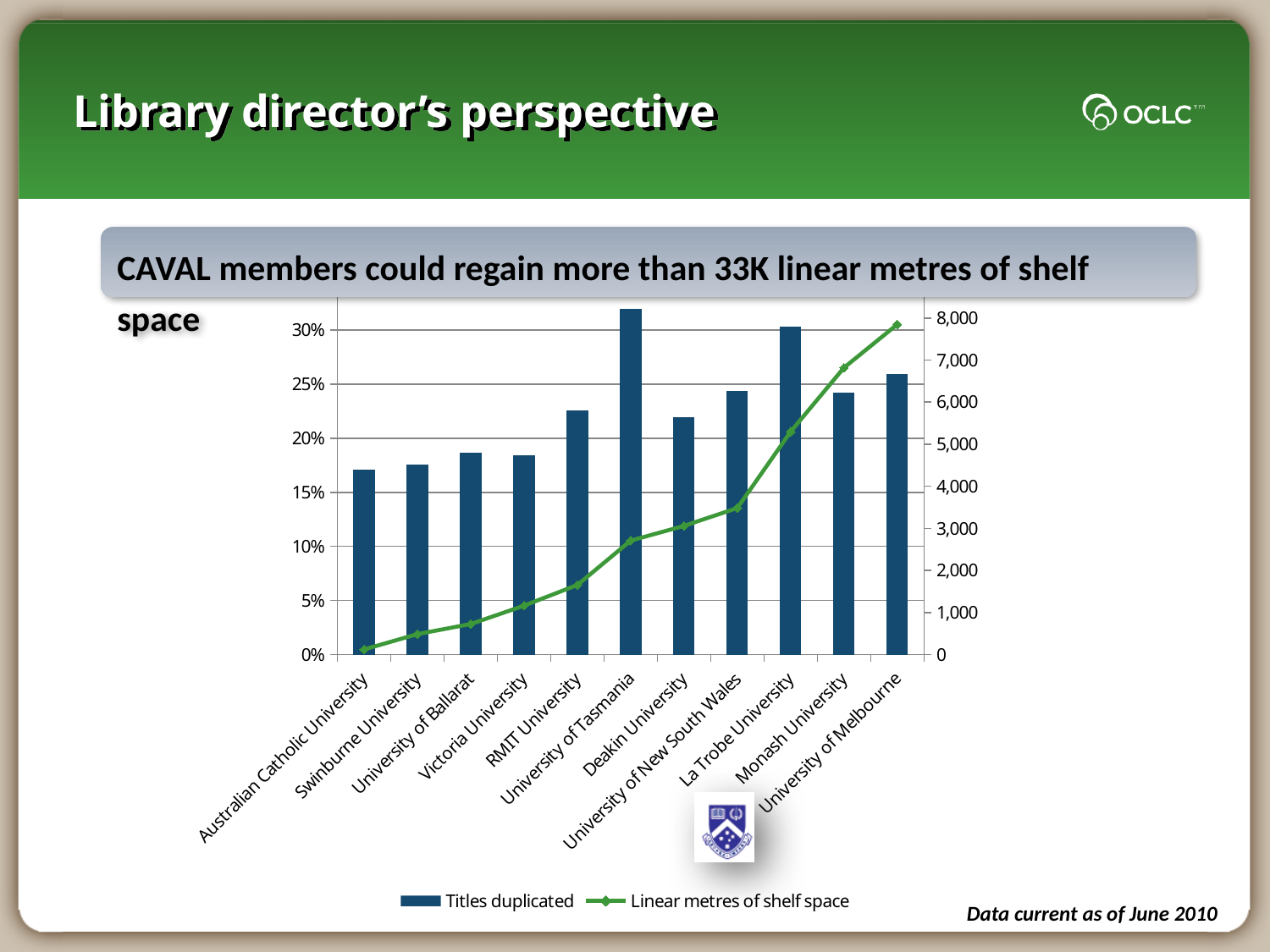
Is the Titles duplicated value for University of Tasmania greater or less than 30%? greater Is the Linear metres of shelf space value for University of Melbourne greater or less than 7,000? greater Is the Titles duplicated value for Australian Catholic University greater or less than 20%? less How many series does the chart legend list? 2 Which university has the highest value for Linear metres of shelf space? University of Melbourne Does the Linear metres of shelf space line rise or fall from left to right across the x axis? rise Which university has the lowest value for Linear metres of shelf space? Australian Catholic University Which has a higher Linear metres of shelf space value, Monash University or University of Melbourne? University of Melbourne Which university has the highest value for Titles duplicated? University of Tasmania Which has a higher Titles duplicated value, University of Tasmania or La Trobe University? University of Tasmania How many universities are shown on the x axis of the chart? 11